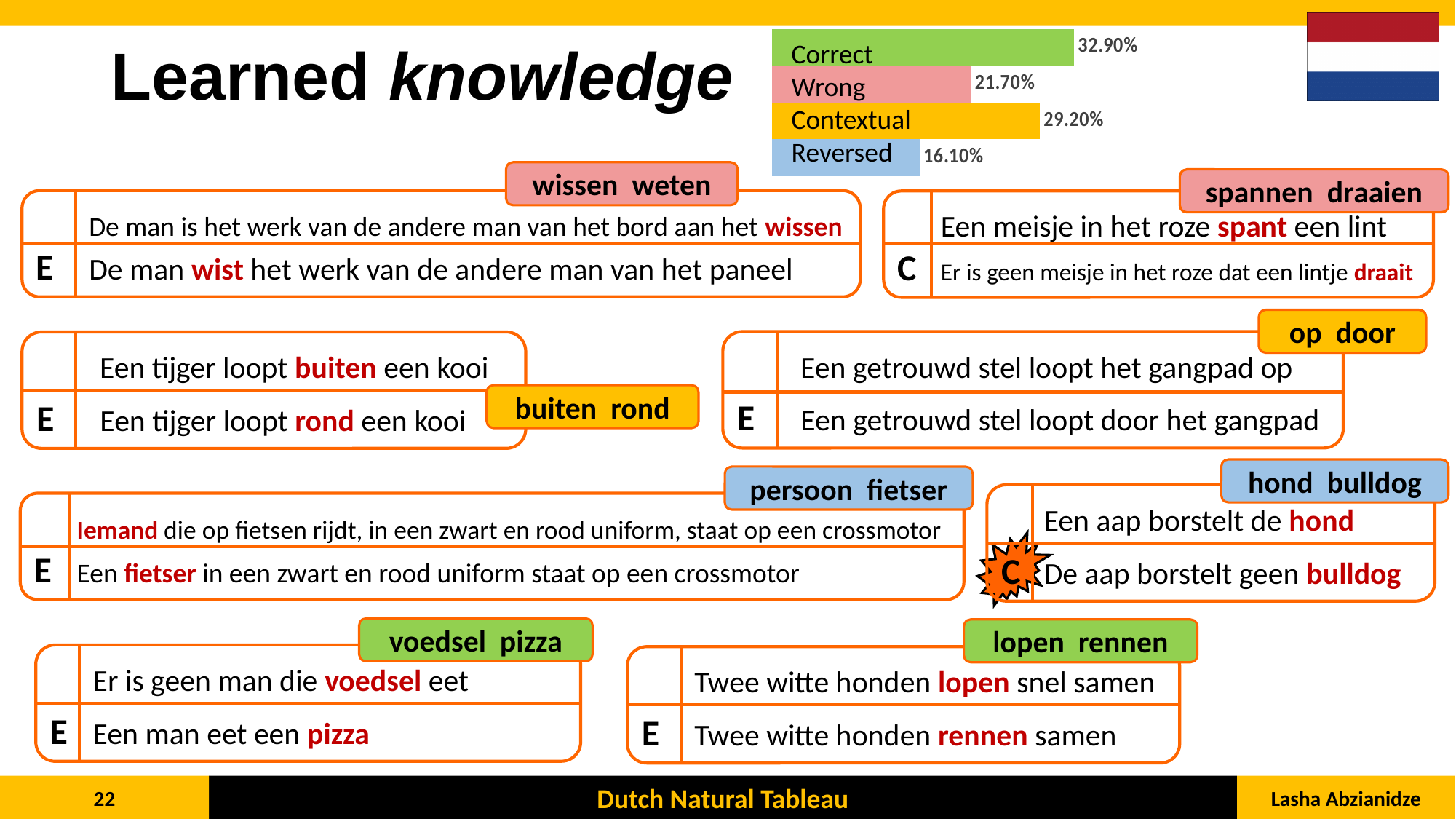
What kind of chart is shown on the slide? Bar chart What colour is the bar for Contextual in the bar chart? Yellow What is the difference between the values for Contextual and Reversed in the bar chart? 13.10% Which category has the highest value in the bar chart? Correct What is the difference between the values for Correct and Wrong in the bar chart? 11.20% What is the value for Wrong in the bar chart? 21.70% What is the value for Correct in the bar chart? 32.90% Which category has the lowest value in the bar chart? Reversed Which is larger in the bar chart, Contextual or Wrong? Contextual What is the value for Reversed in the bar chart? 16.10% What is the value for Contextual in the bar chart? 29.20% How many categories are shown in the bar chart? 4